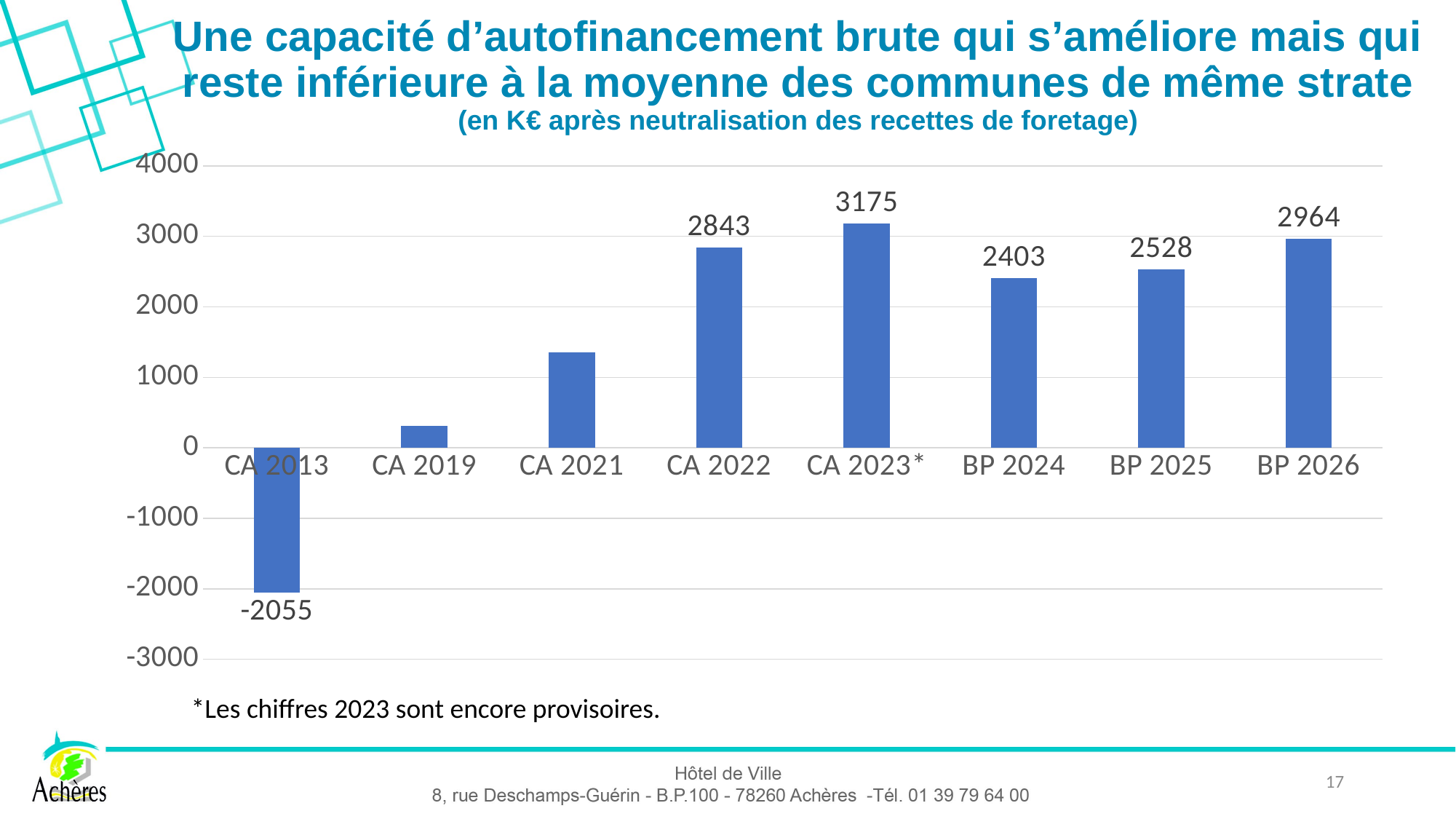
Is the value for CA 2019 greater or less than 1000? less Which is larger, the value for BP 2026 or the value for BP 2025? BP 2026 Which category has the lowest value? CA 2013 What is the value for BP 2025? 2528 What kind of chart is shown on the slide? Bar chart What is the difference between the values for CA 2023* and CA 2022? 332 What is the value for CA 2022? 2843 Is the value for CA 2021 greater or less than 1000? greater How many categories are shown on the x axis? 8 What is the value for CA 2013? -2055 What is the difference between the values for BP 2026 and BP 2024? 561 Which category has the highest value? CA 2023*